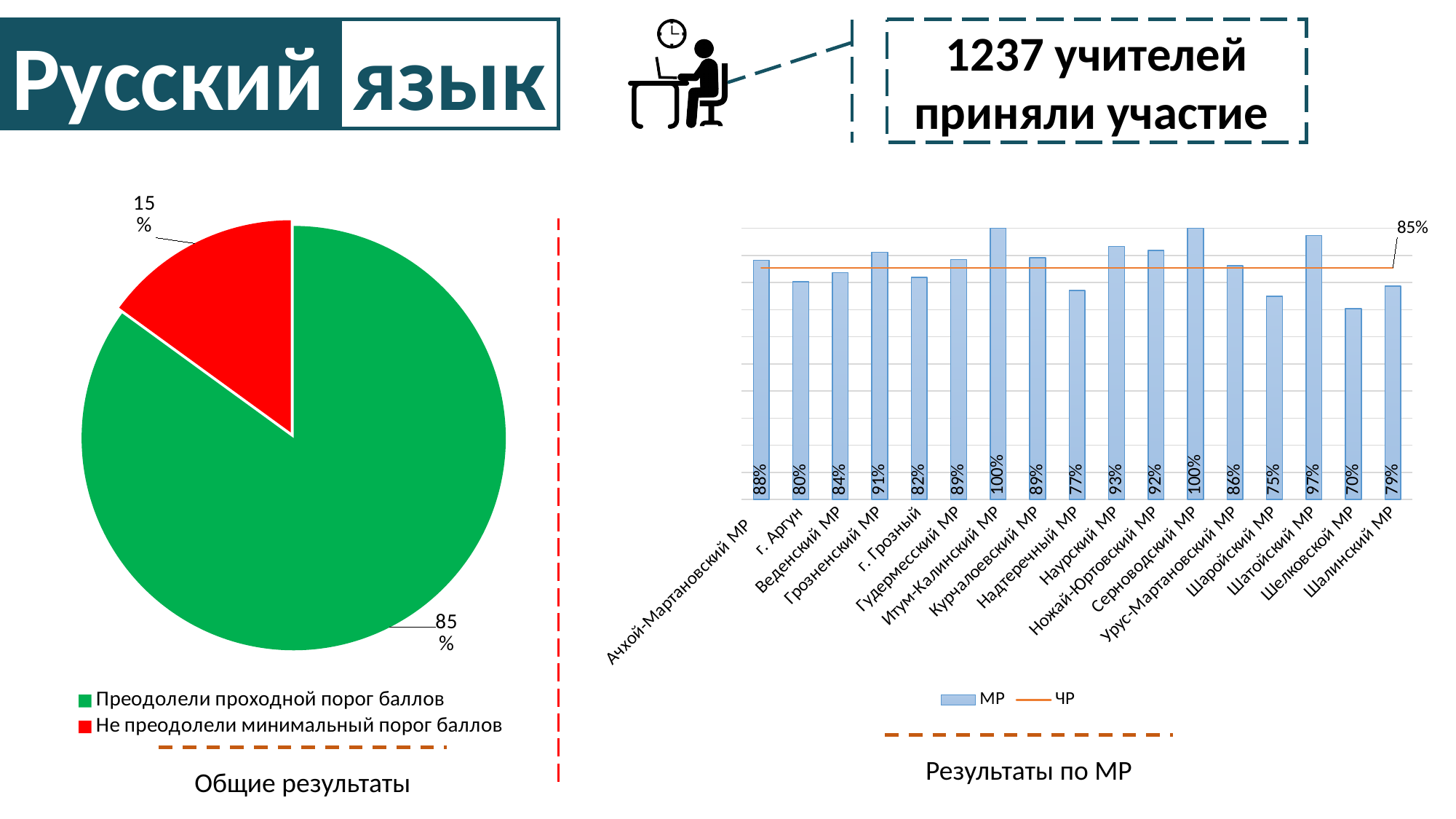
In the bar chart on the right, which is larger: the value for Грозненский МР or the value for г. Грозный? Грозненский МР In the pie chart on the left (Общие результаты), what share of the pie is labelled 'Преодолели проходной порог баллов'? 85% What kind of chart is the chart on the right (Результаты по МР)? Bar chart In the bar chart on the right, what is the value for Надтеречный МР? 77% What kind of chart is the chart on the left of the slide? Pie chart In the bar chart on the right, what is the difference between the values for Наурский МР and г. Аргун? 13% In the bar chart on the right, which district has the lowest value? Шелковской МР In the bar chart on the right, what value is shown for the ЧР line? 85% In the bar chart on the right, how many districts (categories) are shown? 17 In the bar chart on the right, what is the value for Шатойский МР? 97% In the bar chart on the right, how many series does the legend list? 2 In the pie chart on the left, what is the value of the red slice 'Не преодолели минимальный порог баллов'? 15%